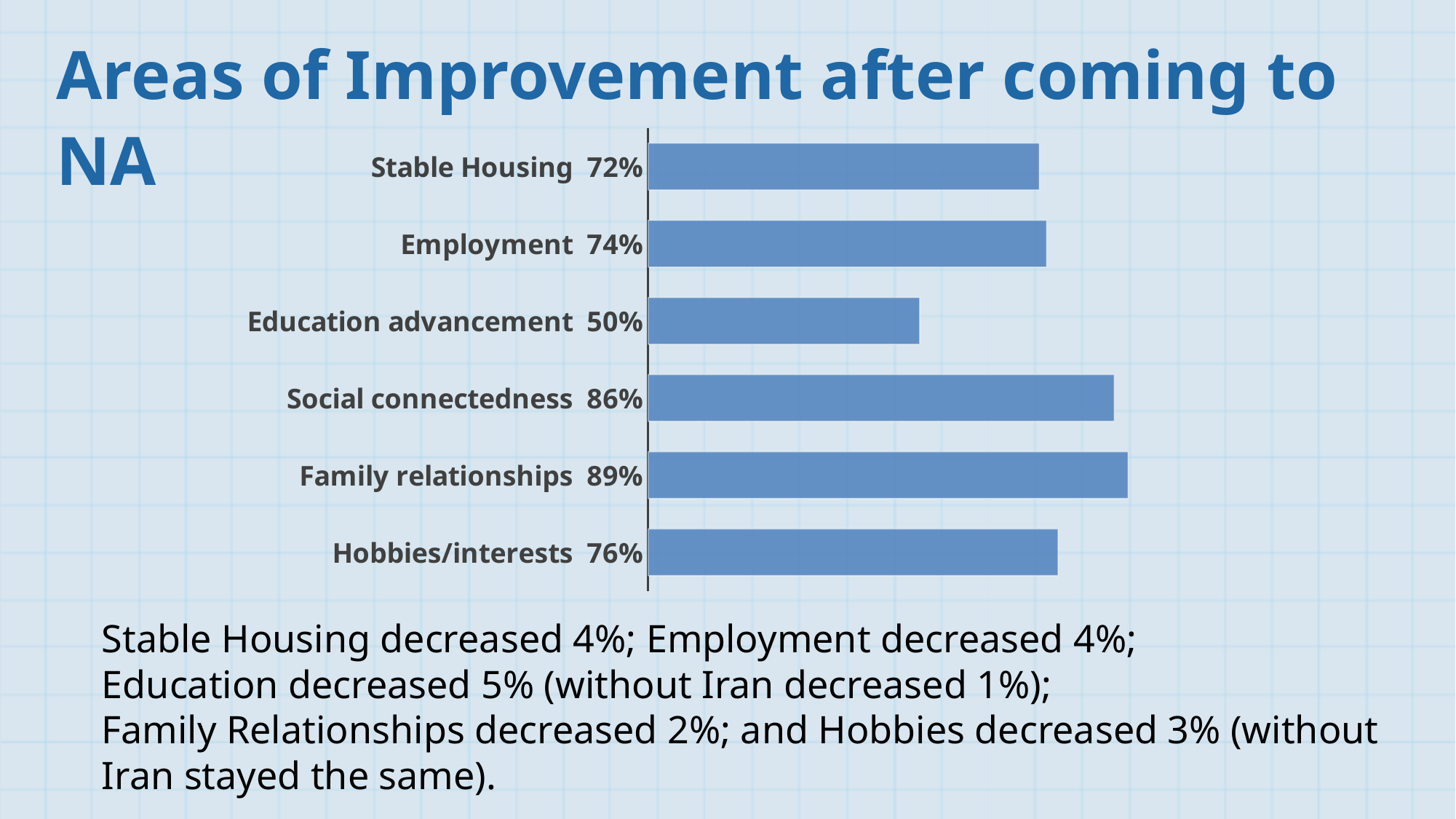
Which category has the lowest value? Education advancement How many categories are shown in the chart? 6 What is the value for Hobbies/interests? 76% What is the value for Stable Housing? 72% What is the difference between Family relationships and Education advancement? 39% What is the value for Education advancement? 50% What is the title of the slide containing the chart? Areas of Improvement after coming to NA Which is larger, Social connectedness or Hobbies/interests? Social connectedness What kind of chart is shown on the slide? Bar chart What is the value for Social connectedness? 86% What is the difference between Employment and Stable Housing? 2% Which category has the highest value? Family relationships